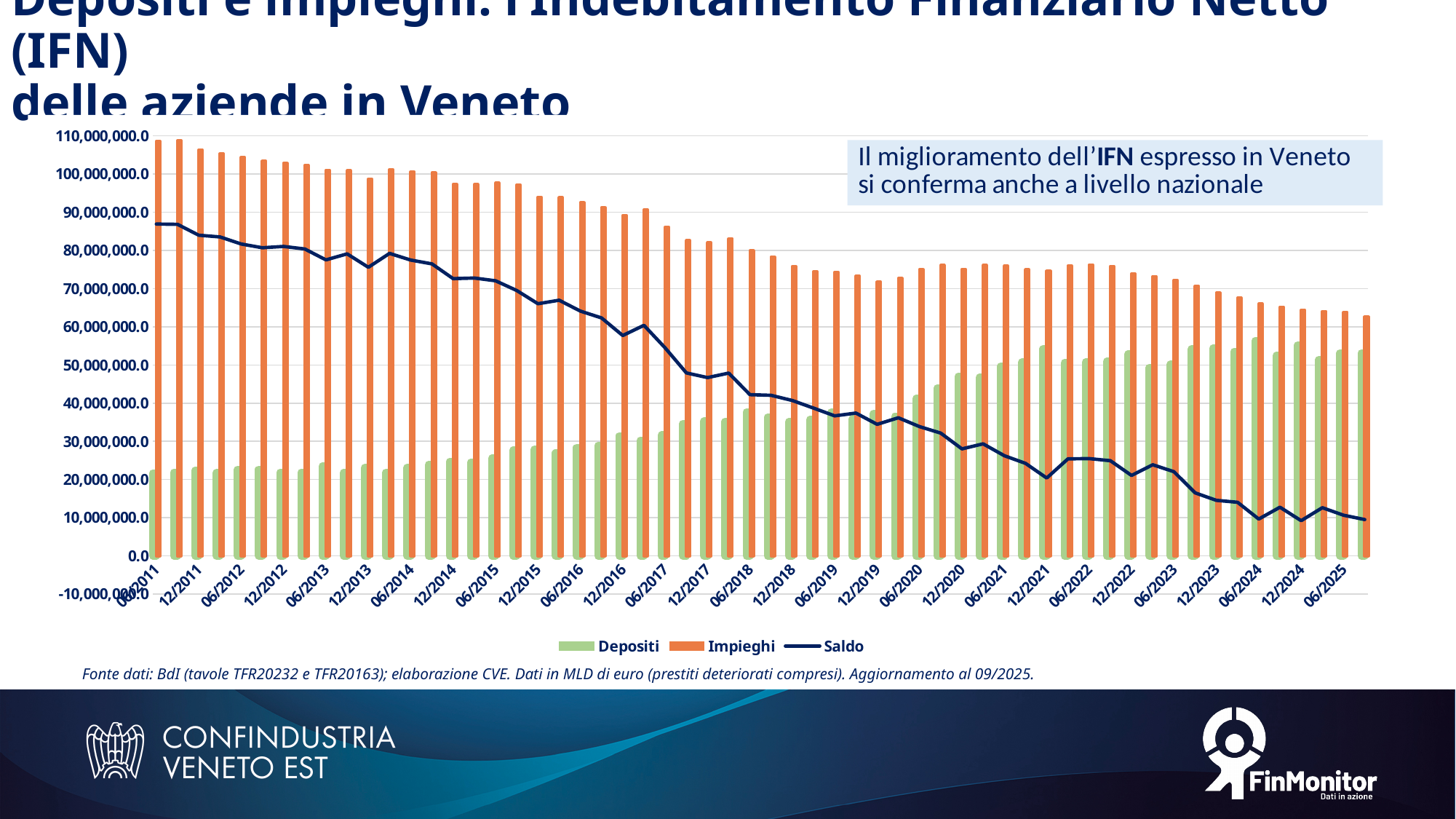
At 06/2011, which is larger: Depositi or Impieghi? Impieghi Do the Impieghi bars generally rise or fall from 06/2011 to 06/2025? Fall Which series is shown in green in the legend? Depositi Is the Impieghi value for 06/2011 greater or less than 100,000,000.0? greater Which is larger: the Saldo value at 06/2011 or at 06/2025? 06/2011 What kind of chart is shown on the slide? Bar chart with a line series Is the Saldo value for 06/2025 greater or less than 20,000,000.0? less Does the Saldo line rise or fall from 06/2011 to 06/2025? Fall How many series does the chart legend list? 3 Is the Depositi value for 06/2011 greater or less than 30,000,000.0? less Do the Depositi bars generally rise or fall from 06/2011 to 06/2025? Rise